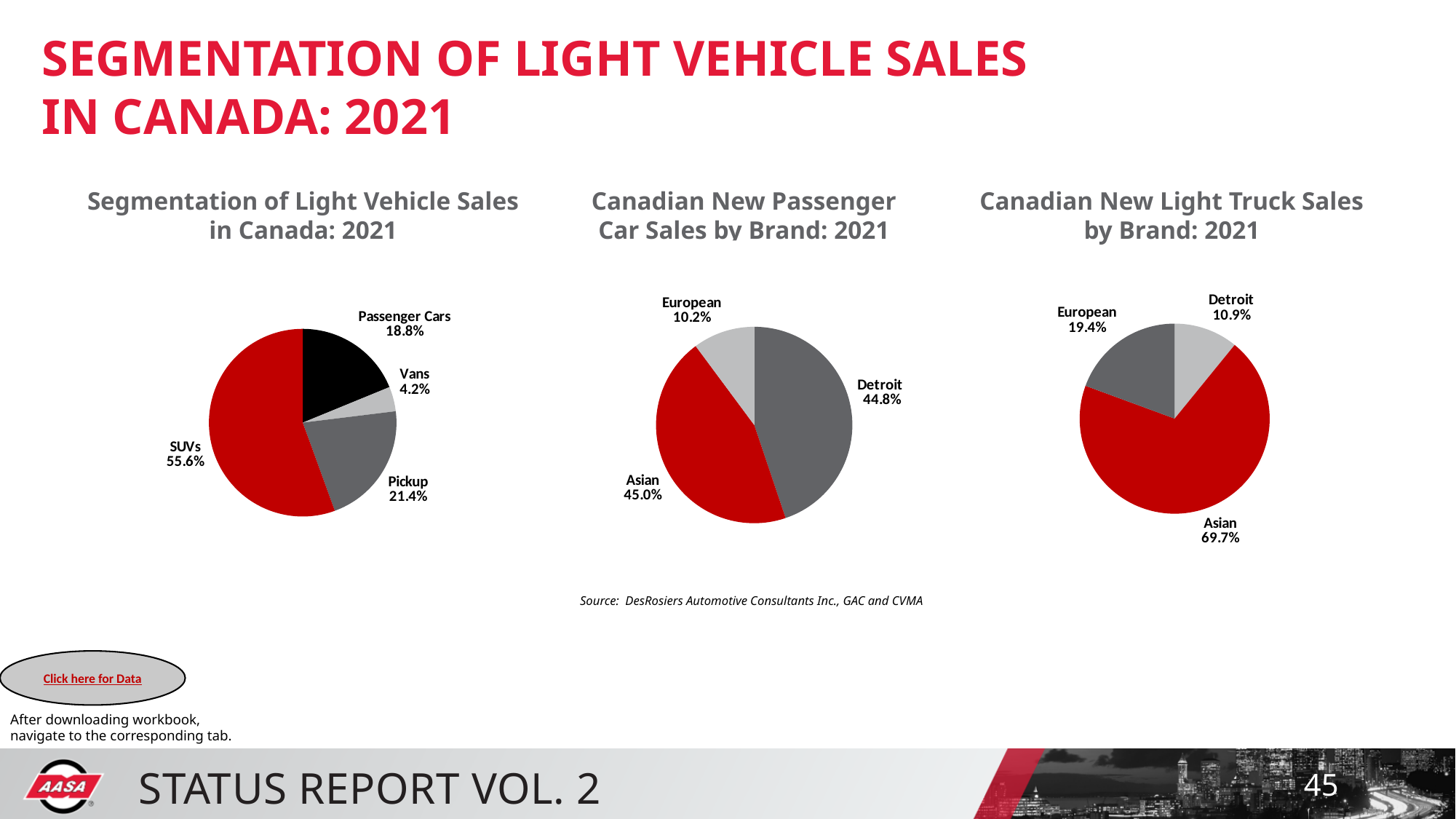
What type of chart is 'Canadian New Passenger Car Sales by Brand: 2021'? Pie chart In the 'Canadian New Light Truck Sales by Brand: 2021' chart, which is larger, the European share or the Detroit share? European In the 'Segmentation of Light Vehicle Sales in Canada: 2021' chart, which segment has the smallest share? Vans In the 'Segmentation of Light Vehicle Sales in Canada: 2021' chart, what share do SUVs have? 55.6% How many segments are shown in the 'Segmentation of Light Vehicle Sales in Canada: 2021' chart? 4 In the 'Canadian New Light Truck Sales by Brand: 2021' chart, which brand group has the largest share? Asian In the 'Segmentation of Light Vehicle Sales in Canada: 2021' chart, what is the difference between the Pickup share and the Passenger Cars share? 2.6% In the 'Canadian New Passenger Car Sales by Brand: 2021' chart, which brand group has the smallest share? European In the 'Segmentation of Light Vehicle Sales in Canada: 2021' chart, what colour is the SUVs slice? Red In the 'Canadian New Light Truck Sales by Brand: 2021' chart, what share do Asian brands have? 69.7% In the 'Canadian New Light Truck Sales by Brand: 2021' chart, what is the difference between the Asian share and the European share? 50.3% In the 'Canadian New Passenger Car Sales by Brand: 2021' chart, what share do European brands have? 10.2%